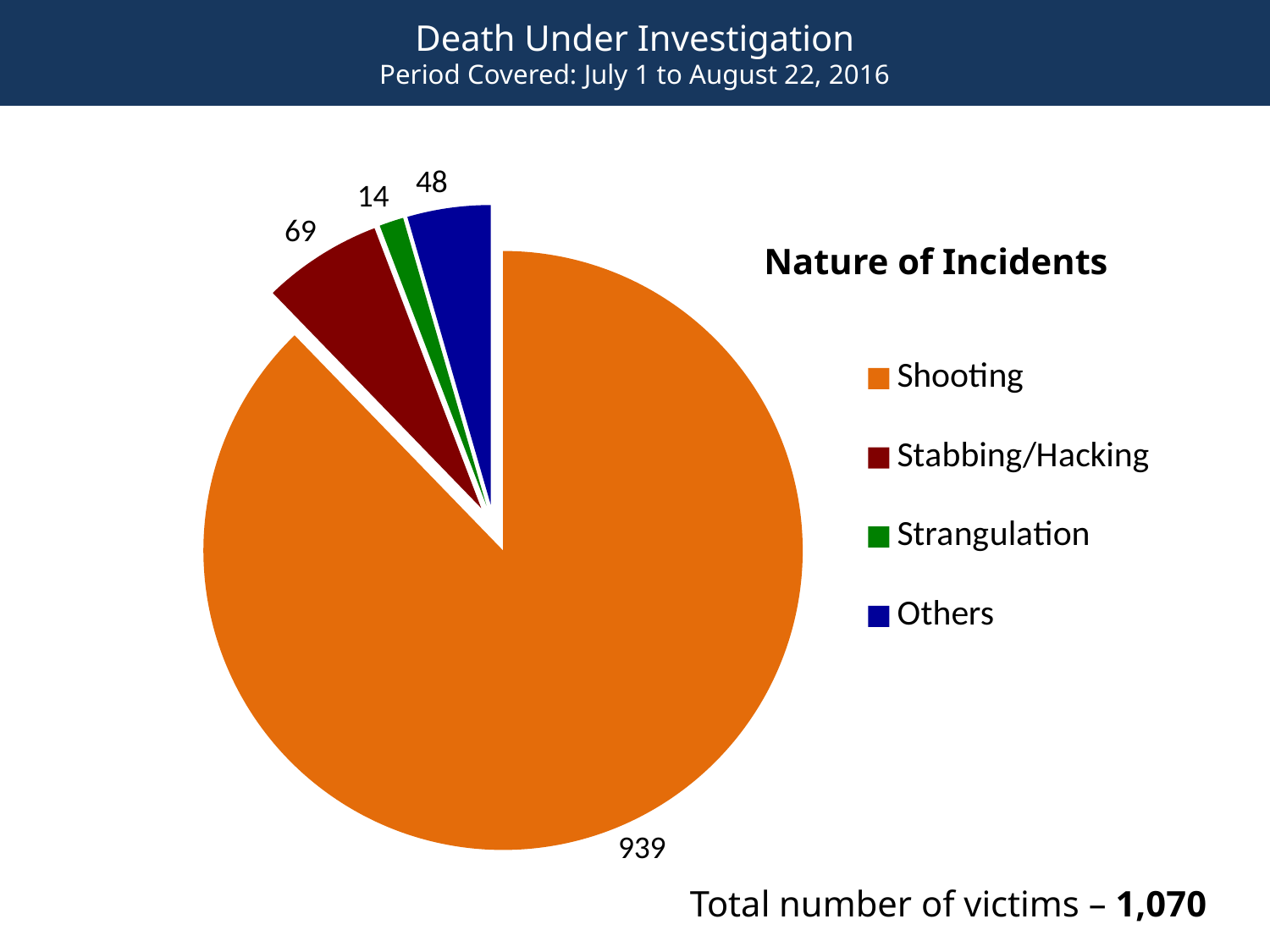
What is the total number of victims stated on the slide? 1,070 What is the difference between the Shooting and Stabbing/Hacking values? 870 How many categories does the pie chart show? 4 What type of chart is shown on the slide? Pie chart What is the difference between the Others and Strangulation values? 34 What is the value for Shooting in the Nature of Incidents pie chart? 939 Which category has the largest slice in the pie chart? Shooting Which is larger, Stabbing/Hacking or Others? Stabbing/Hacking What is the value for Stabbing/Hacking in the pie chart? 69 Which category has the smallest slice in the pie chart? Strangulation What is the value for Others in the pie chart? 48 What is the value for Strangulation in the pie chart? 14